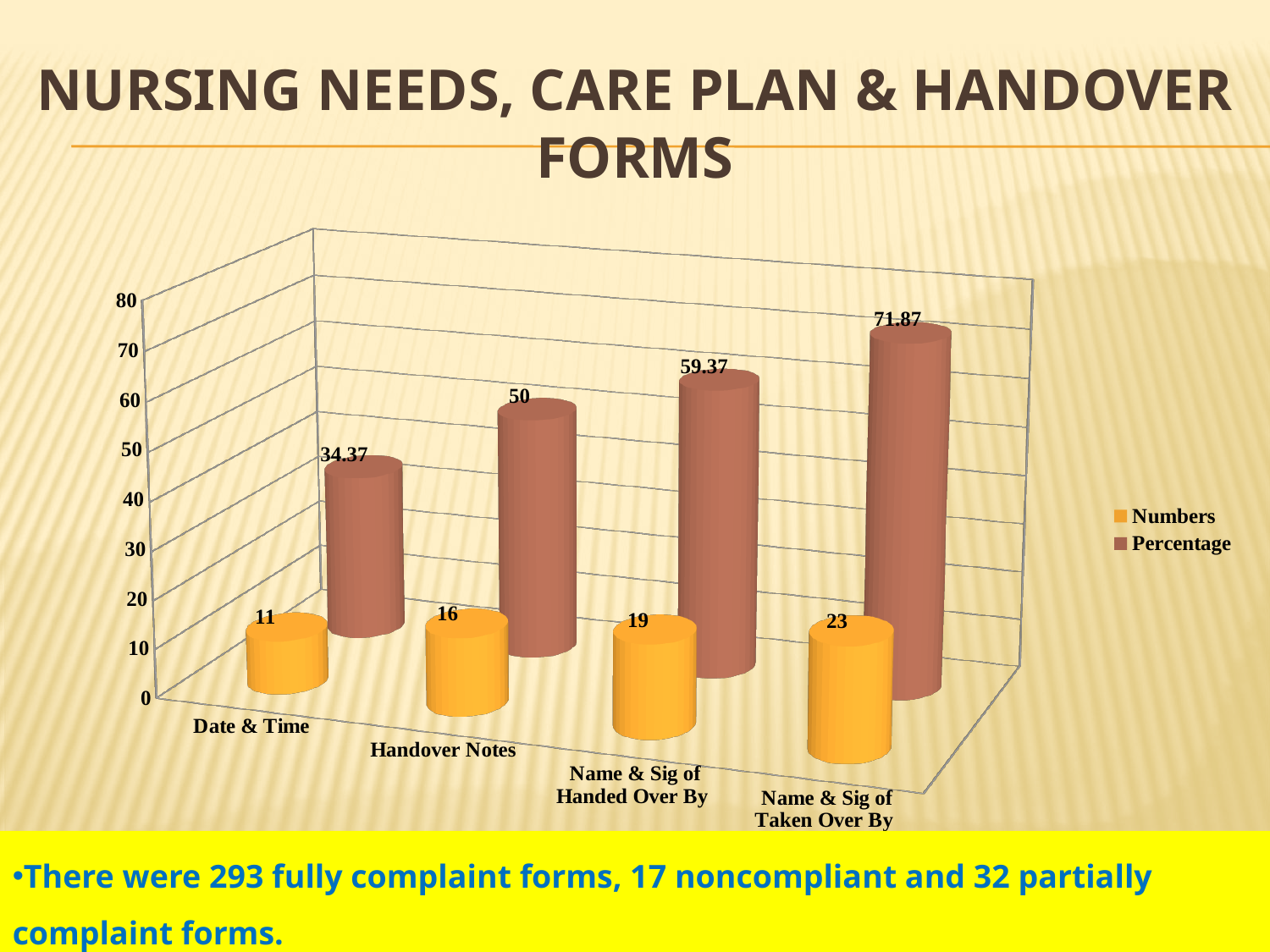
What kind of chart is shown on the slide? Bar chart What is the difference between the Numbers values for Name & Sig of Taken Over By and Date & Time? 12 Which category has the highest Percentage value? Name & Sig of Taken Over By How many categories are shown on the x axis? 4 Which is larger, the Percentage value for Handover Notes or for Name & Sig of Handed Over By? Name & Sig of Handed Over By What is the Numbers value for Handover Notes? 16 What is the Percentage value for Date & Time? 34.37 What is the Percentage value for Name & Sig of Taken Over By? 71.87 Which series is shown in orange in the legend? Numbers Do the Percentage values rise or fall from left to right along the x axis? Rise Which category has the lowest Numbers value? Date & Time How many series does the legend list? 2